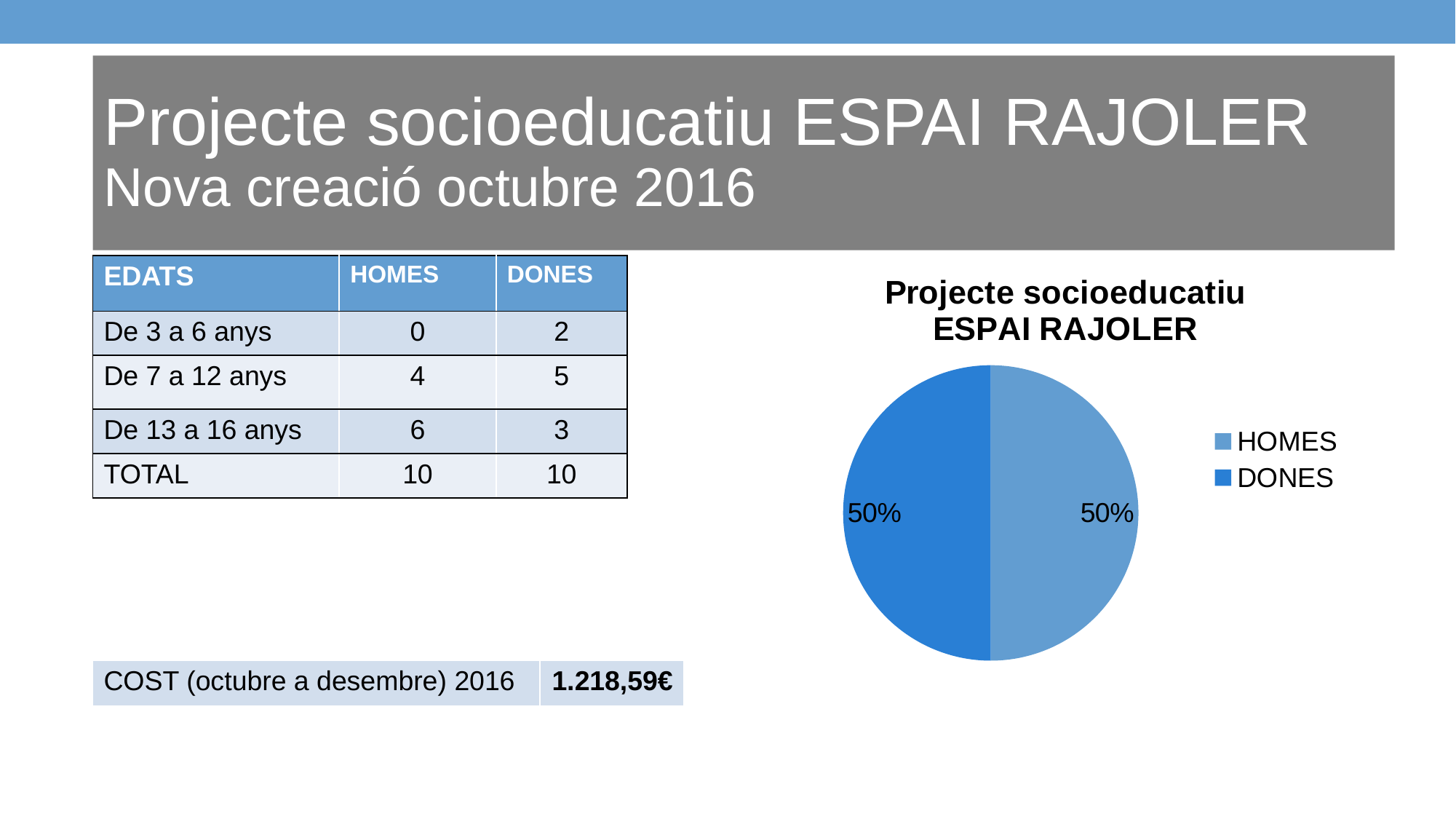
How many entries does the pie chart's legend list? 2 What are the two categories listed in the pie chart's legend? HOMES and DONES What is the difference between the HOMES share and the DONES share in the pie chart? 0% What is the data label shown on the DONES slice of the pie chart? 50% How many slices does the pie chart have? 2 What share of the pie chart does HOMES represent? 50% What share of the pie chart does DONES represent? 50% What kind of chart is shown on the slide? pie chart What is the title of the pie chart? Projecte socioeducatiu ESPAI RAJOLER What is the data label shown on the HOMES slice of the pie chart? 50%